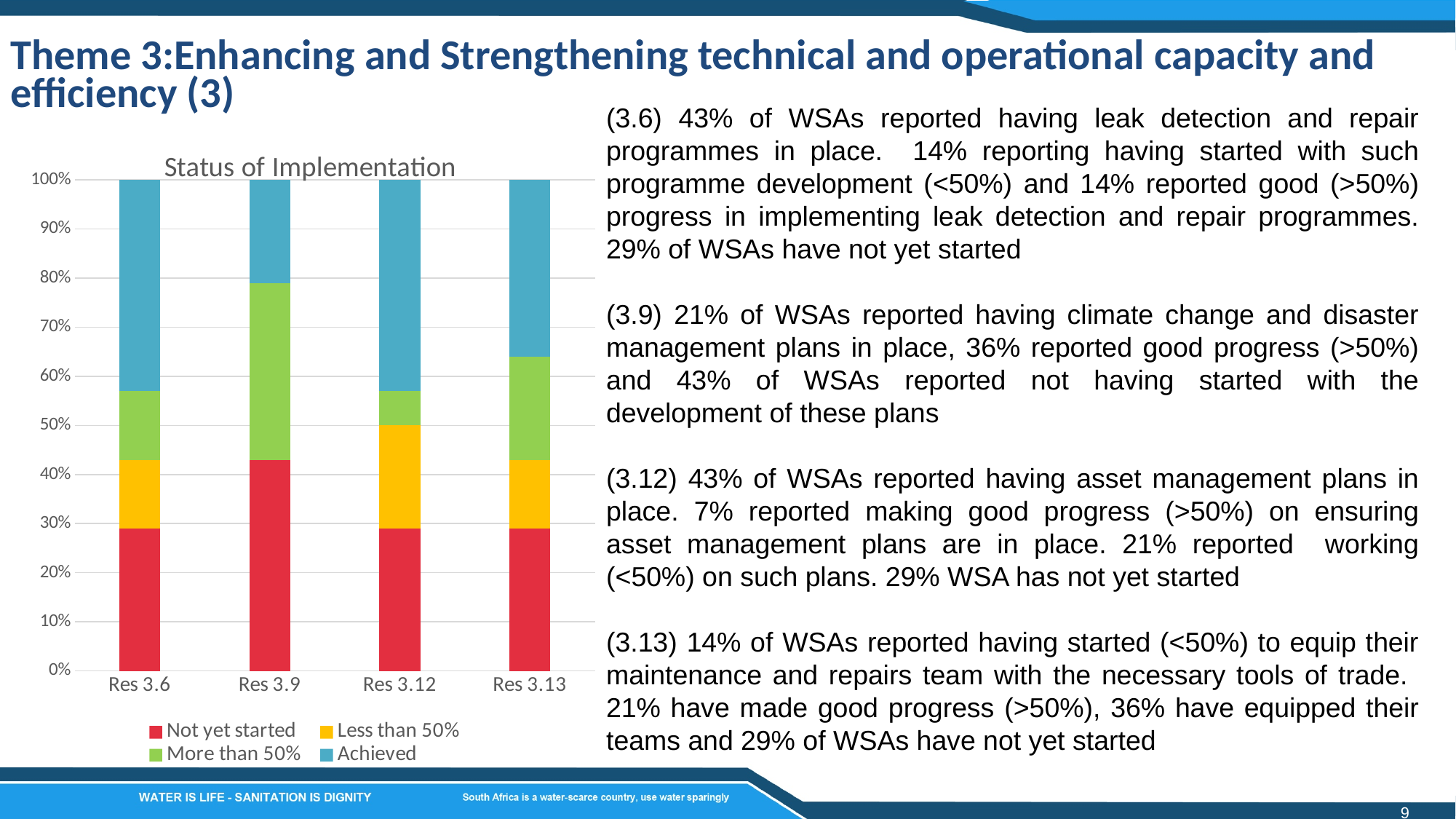
How many series does the chart legend list? 4 Is the 'Not yet started' value for Res 3.9 greater or less than 40%? greater How many categories are shown on the x axis of the chart? 4 Which category has the largest 'Not yet started' segment? Res 3.9 What is the total of the stacked bar for Res 3.13? 100% Which category has the largest 'More than 50%' segment? Res 3.9 What type of chart is shown on the slide? Stacked bar chart Which category has the smallest 'More than 50%' segment? Res 3.12 Which colour represents the 'Achieved' series in the chart? Blue What is the title of the chart? Status of Implementation Which category has the smallest 'Achieved' segment? Res 3.9 Is the 'Not yet started' segment larger for Res 3.6 or Res 3.9? Res 3.9